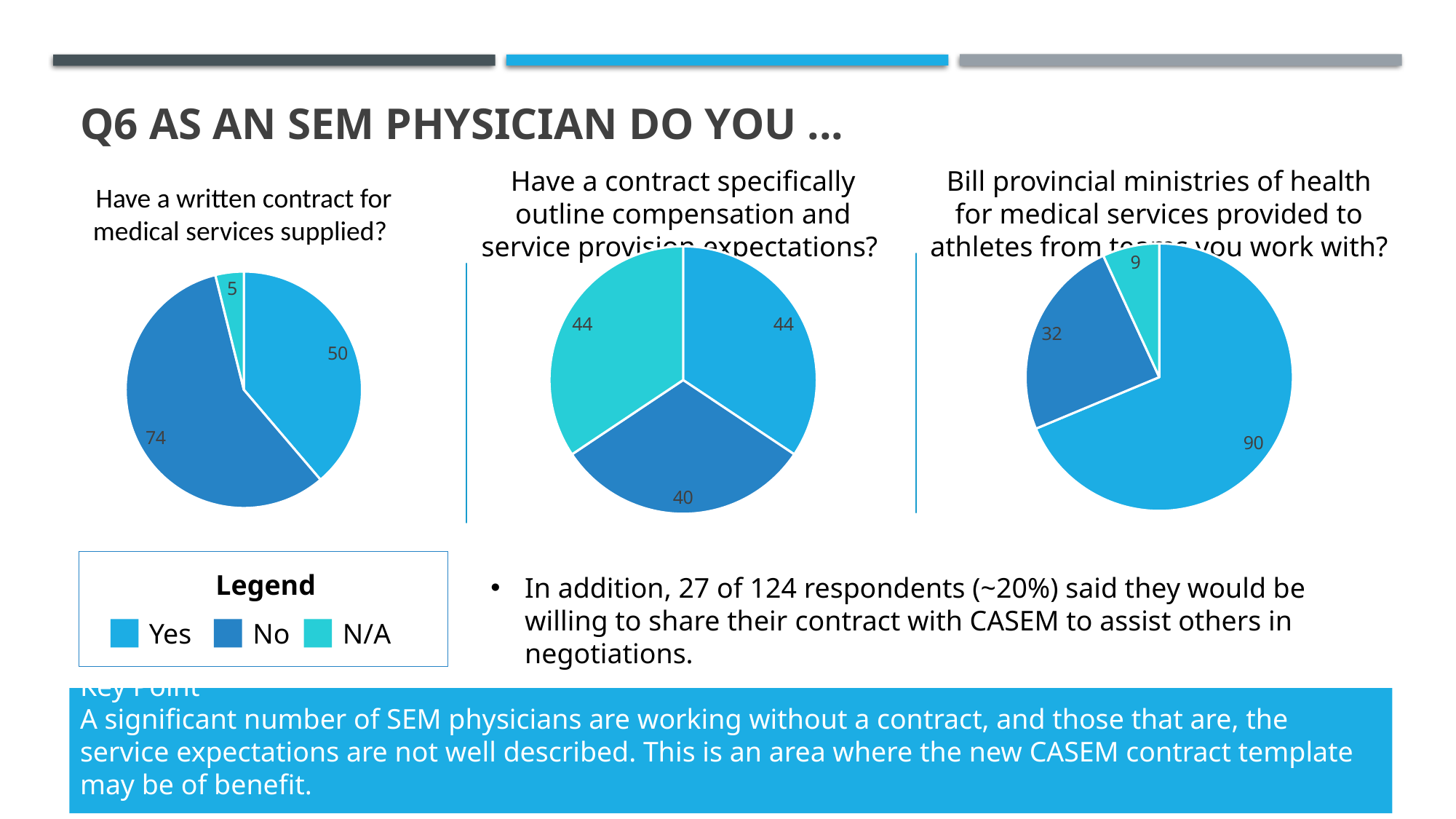
In the pie chart 'Have a written contract for medical services supplied?', what is the value for Yes? 50 What type of chart is used for the three questions on the slide? Pie chart In the pie chart 'Have a written contract for medical services supplied?', which category has the smallest slice? N/A In the pie chart 'Bill provincial ministries of health for medical services provided to athletes from teams you work with?', what is the difference between the Yes and No values? 58 In the pie chart 'Have a written contract for medical services supplied?', what is the difference between the No and Yes values? 24 In the pie chart 'Bill provincial ministries of health for medical services provided to athletes from teams you work with?', what is the value for Yes? 90 In the middle pie chart about a contract outlining compensation and service provision expectations, what is the value for No? 40 In the pie chart 'Bill provincial ministries of health for medical services provided to athletes from teams you work with?', which is larger, No or N/A? No In the pie chart 'Have a written contract for medical services supplied?', what is the value for No? 74 In the middle pie chart about a contract outlining compensation and service provision expectations, what is the value for N/A? 44 How many categories does the legend list for the pie charts? 3 In the pie chart 'Bill provincial ministries of health for medical services provided to athletes from teams you work with?', which category has the largest slice? Yes